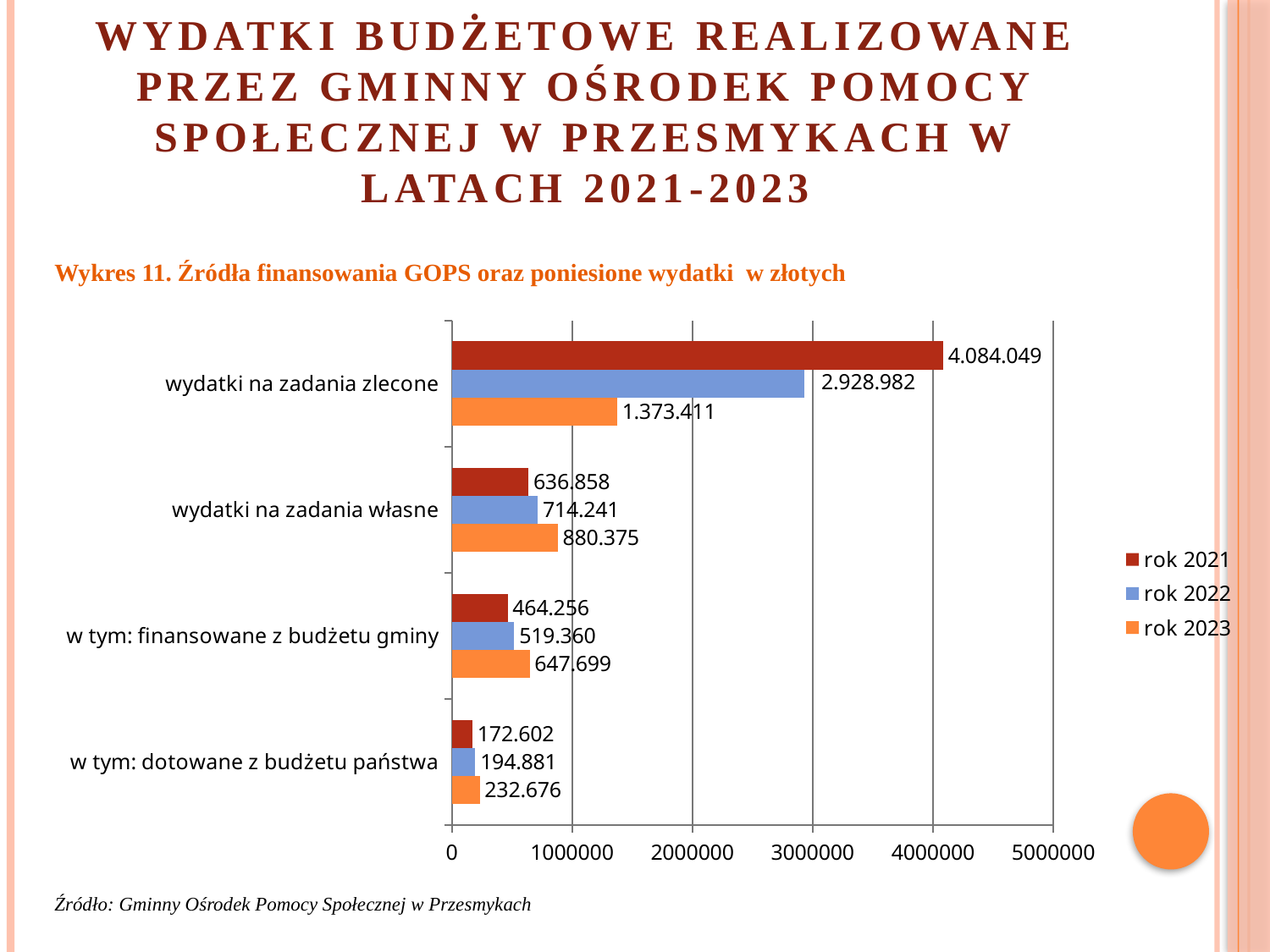
What is the difference between the 'rok 2021' and 'rok 2022' values for 'wydatki na zadania zlecone'? 1.155.067 What is the value for 'w tym: finansowane z budżetu gminy' in the 'rok 2023' series? 647.699 What kind of chart is shown on the slide? bar chart How many series does the legend list? 3 What is the value for 'w tym: dotowane z budżetu państwa' in the 'rok 2022' series? 194.881 Which category has the lowest value in the 'rok 2023' series? w tym: dotowane z budżetu państwa Which category has the highest value in the 'rok 2021' series? wydatki na zadania zlecone For 'wydatki na zadania własne', which is larger: the 'rok 2022' value or the 'rok 2021' value? rok 2022 What is the value for 'wydatki na zadania własne' in the 'rok 2023' series? 880.375 How many categories are shown on the chart? 4 What is the difference between the 'rok 2023' and 'rok 2021' values for 'wydatki na zadania własne'? 243.517 What is the value for 'wydatki na zadania zlecone' in the 'rok 2021' series? 4.084.049